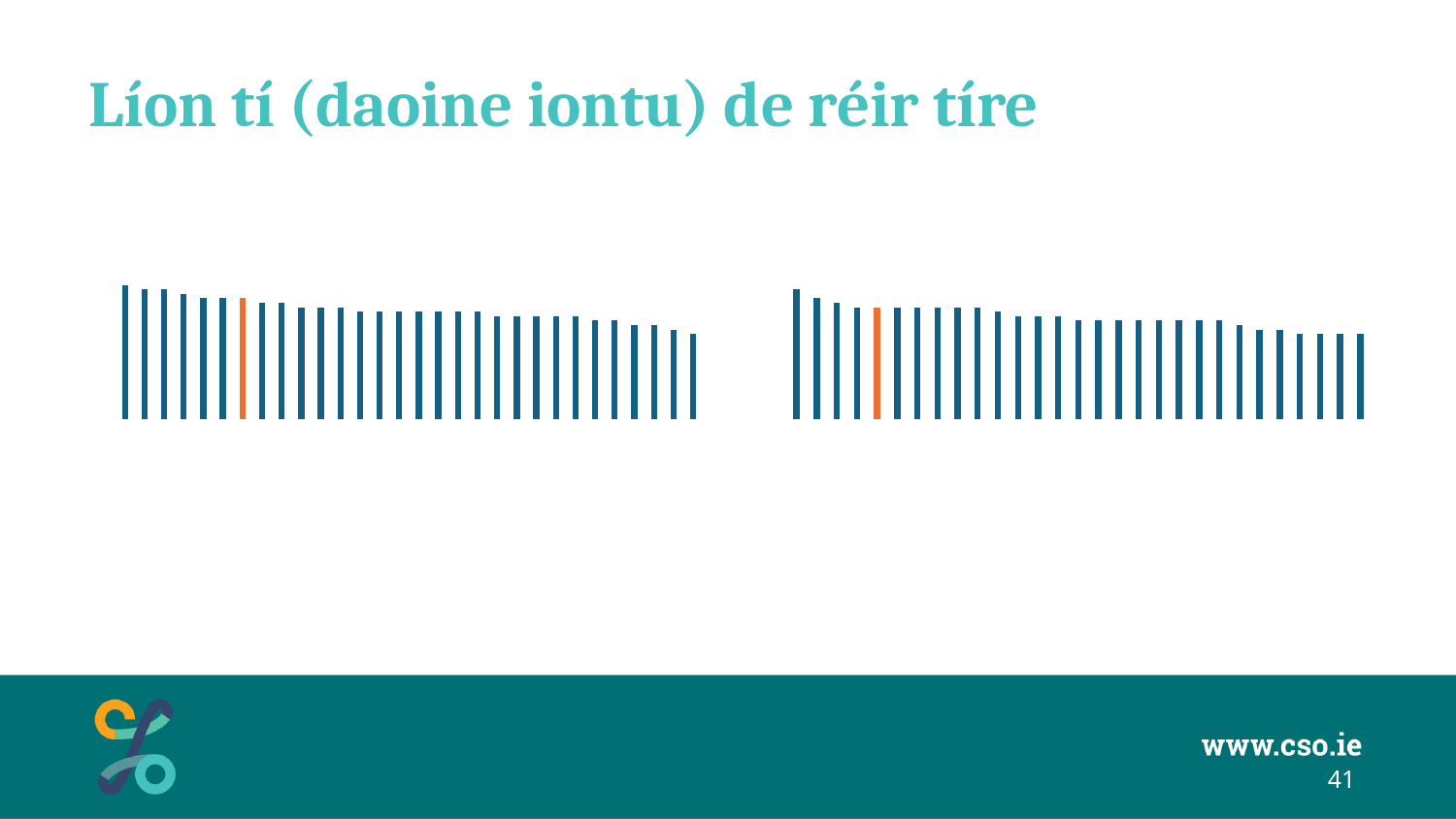
What kind of chart is the chart on the left of the slide? bar chart What is the title of the slide containing the two charts? Líon tí (daoine iontu) de réir tíre In the chart on the left, which bar is the tallest: the leftmost or the rightmost? the leftmost What kind of chart is the chart on the right of the slide? bar chart What colour is the single highlighted bar in each chart? orange In the chart on the left, do the bar values rise or fall from left to right? fall In the chart on the right, which bar is the shortest: the leftmost or the rightmost? the rightmost In the chart on the right, do the bar values rise or fall from left to right? fall